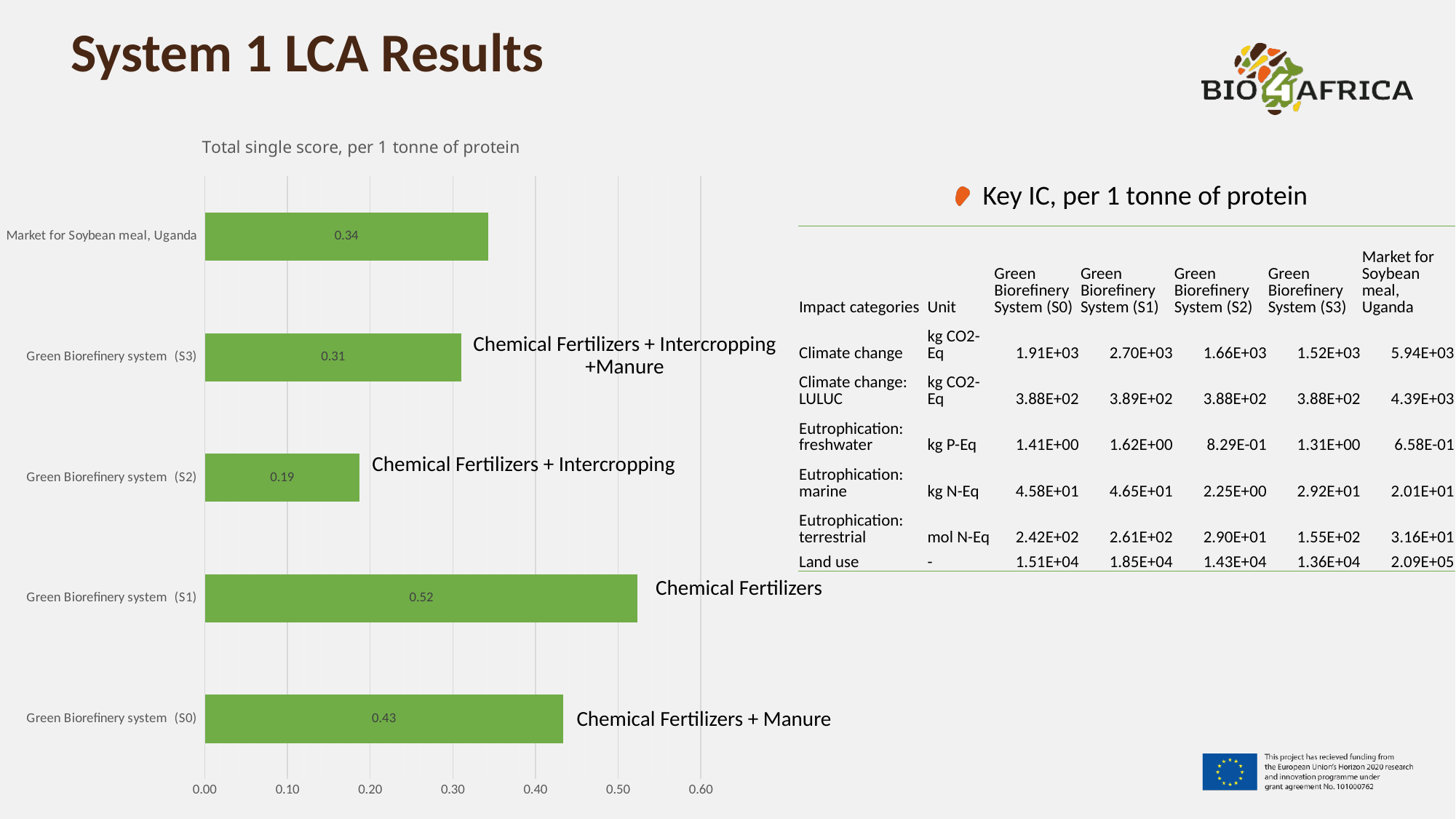
What is the title of the chart? Total single score, per 1 tonne of protein How many categories are shown in the bar chart? 5 What is the total single score for Green Biorefinery system (S1)? 0.52 Which has a larger total single score, Green Biorefinery system (S0) or Market for Soybean meal, Uganda? Green Biorefinery system (S0) Which category has the lowest total single score? Green Biorefinery system (S2) Which category has the highest total single score? Green Biorefinery system (S1) Is the value for Green Biorefinery system (S1) greater or less than 0.50? greater What is the total single score for Market for Soybean meal, Uganda? 0.34 What is the total single score for Green Biorefinery system (S2)? 0.19 What kind of chart is shown on the slide? Bar chart What annotation is written next to the bar for Green Biorefinery system (S2)? Chemical Fertilizers + Intercropping What is the difference between the total single scores of Green Biorefinery system (S0) and Green Biorefinery system (S3)? 0.12